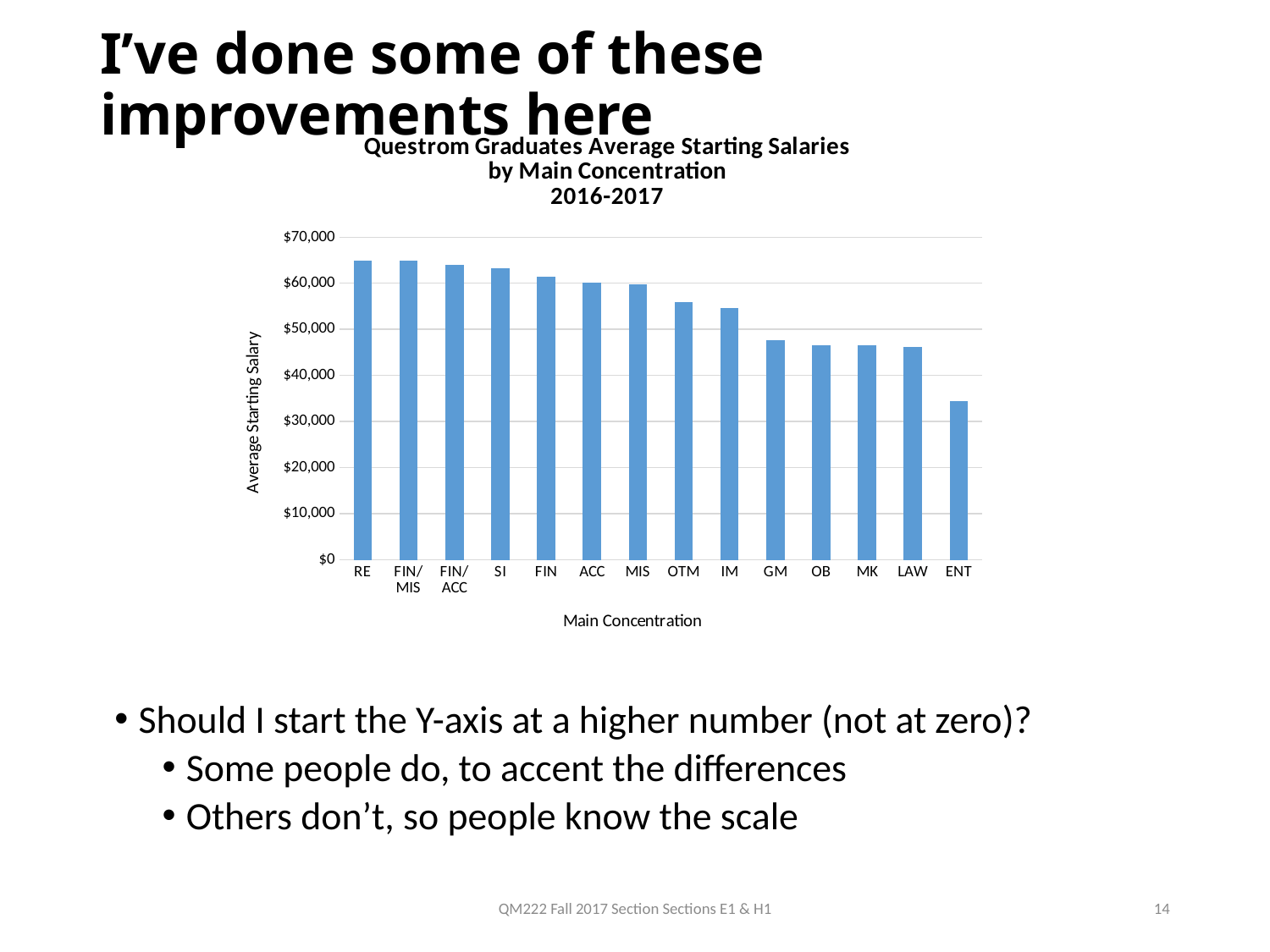
Is the average starting salary for RE greater or less than $60,000? greater What kind of chart is shown on the slide? bar chart Which has a higher average starting salary, OTM or GM? OTM Do the bar values generally rise or fall moving from left to right along the x axis? fall What is the title of the chart? Questrom Graduates Average Starting Salaries by Main Concentration 2016-2017 How many main concentrations are plotted on the x axis of the chart? 14 Is the average starting salary for GM greater or less than $50,000? less What is the label on the chart's y axis? Average Starting Salary Which has a higher average starting salary, LAW or ENT? LAW Is the average starting salary for ENT greater or less than $40,000? less Which main concentration has the lowest average starting salary in the chart? ENT